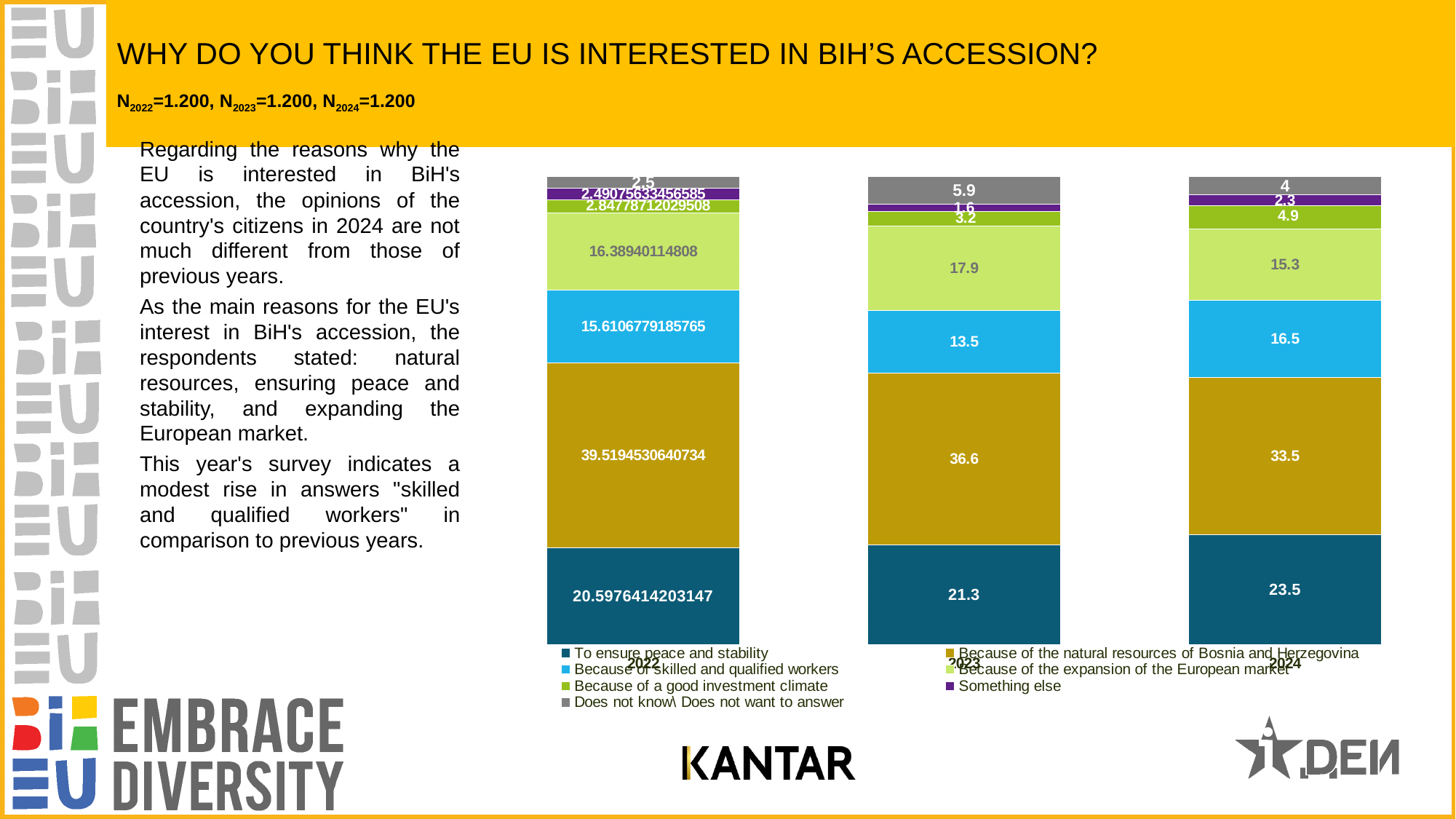
What is the value for 'Does not know\ Does not want to answer' in 2023? 5.9 What is the value for 'Because of skilled and qualified workers' in 2024? 16.5 What is the value for 'Because of the natural resources of Bosnia and Herzegovina' in 2024? 33.5 How many years (bars) are shown in the chart? 3 In 2024, which is larger: 'Because of skilled and qualified workers' or 'Because of the expansion of the European market'? Because of skilled and qualified workers Does the value for 'Because of the natural resources of Bosnia and Herzegovina' rise or fall from 2022 to 2024? Fall How many series does the legend list? 7 Which reason has the lowest value in the 2023 bar? Something else What type of chart is shown on the slide? Stacked bar chart Which reason has the highest value in the 2024 bar? Because of the natural resources of Bosnia and Herzegovina What is the value for 'To ensure peace and stability' in 2023? 21.3 What is the difference between the 'To ensure peace and stability' values for 2024 and 2023? 2.2